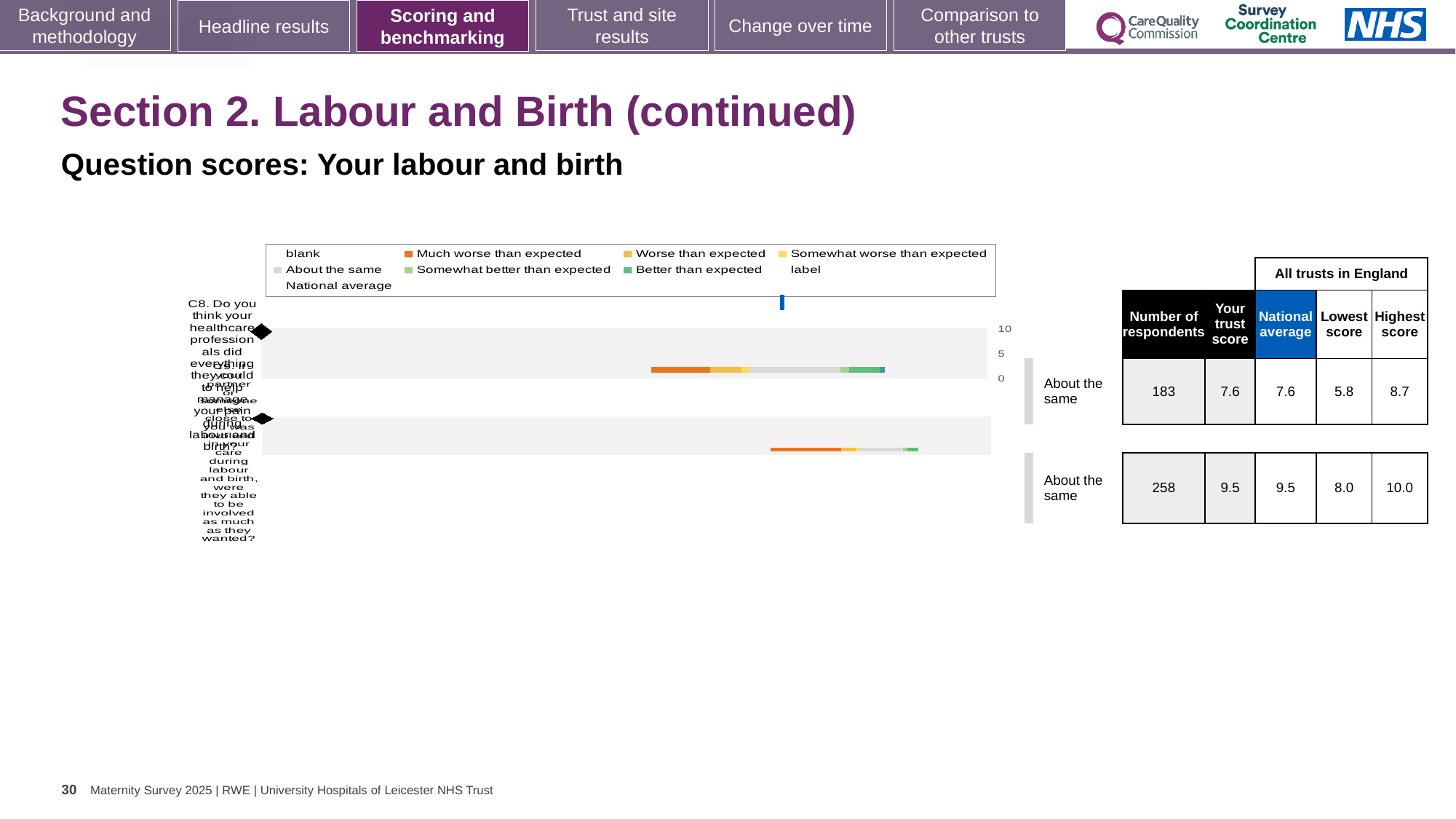
What is the trust score for the second question row (partner or someone close being involved in care)? 9.5 What benchmark category is shown for question C8? About the same What is the number of respondents for question C8 (managing pain during labour and birth)? 183 What is the national average for question C8 (managing pain during labour and birth)? 7.6 What is the difference between the highest score and the lowest score for question C8? 2.9 What is the highest score across all trusts in England for question C8? 8.7 Which question row has more respondents, C8 or the second question row? The second question row What is the number of respondents for the second question row (partner or someone close being involved in care)? 258 What is the trust score for question C8 (managing pain during labour and birth)? 7.6 What is the lowest score across all trusts in England for question C8? 5.8 What kind of chart is shown on the slide? Bar chart How many question rows are plotted in the chart? 2